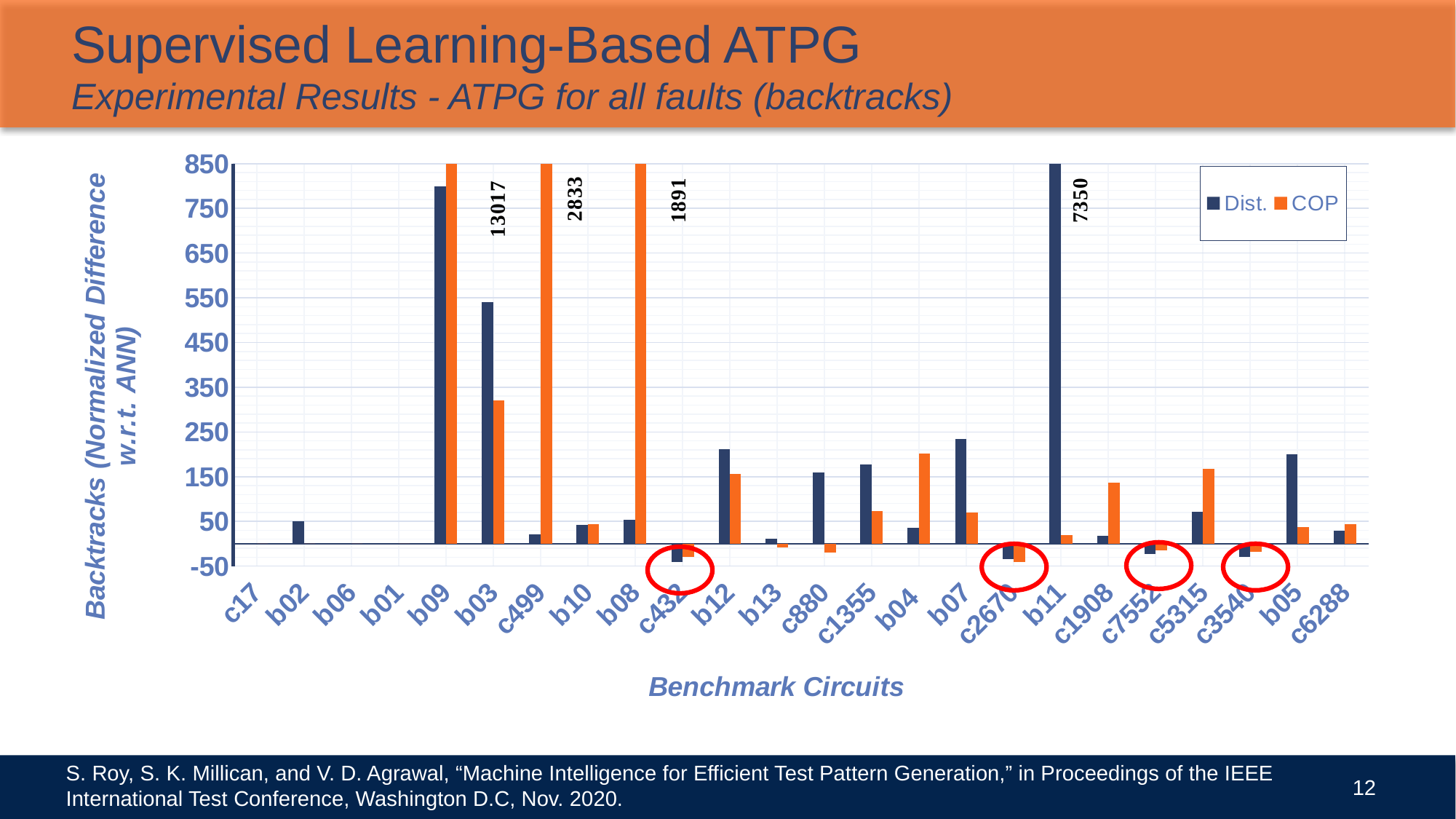
Which benchmark circuit has the highest COP value? b09 What is the COP value labelled for c499? 2833 How many benchmark circuits are shown on the x axis? 24 What is the title of the x axis? Benchmark Circuits For c5315, which series has the larger value, Dist. or COP? COP Is the COP value for b03 greater or less than 250? greater How many series does the legend list? 2 What is the difference between the COP value for c499 (2833) and the COP value for b08 (1891)? 942 What is the COP value labelled for b09? 13017 What kind of chart is shown on the slide? bar chart Is the Dist. value for b03 greater or less than 450? greater What is the Dist. value labelled for b11? 7350